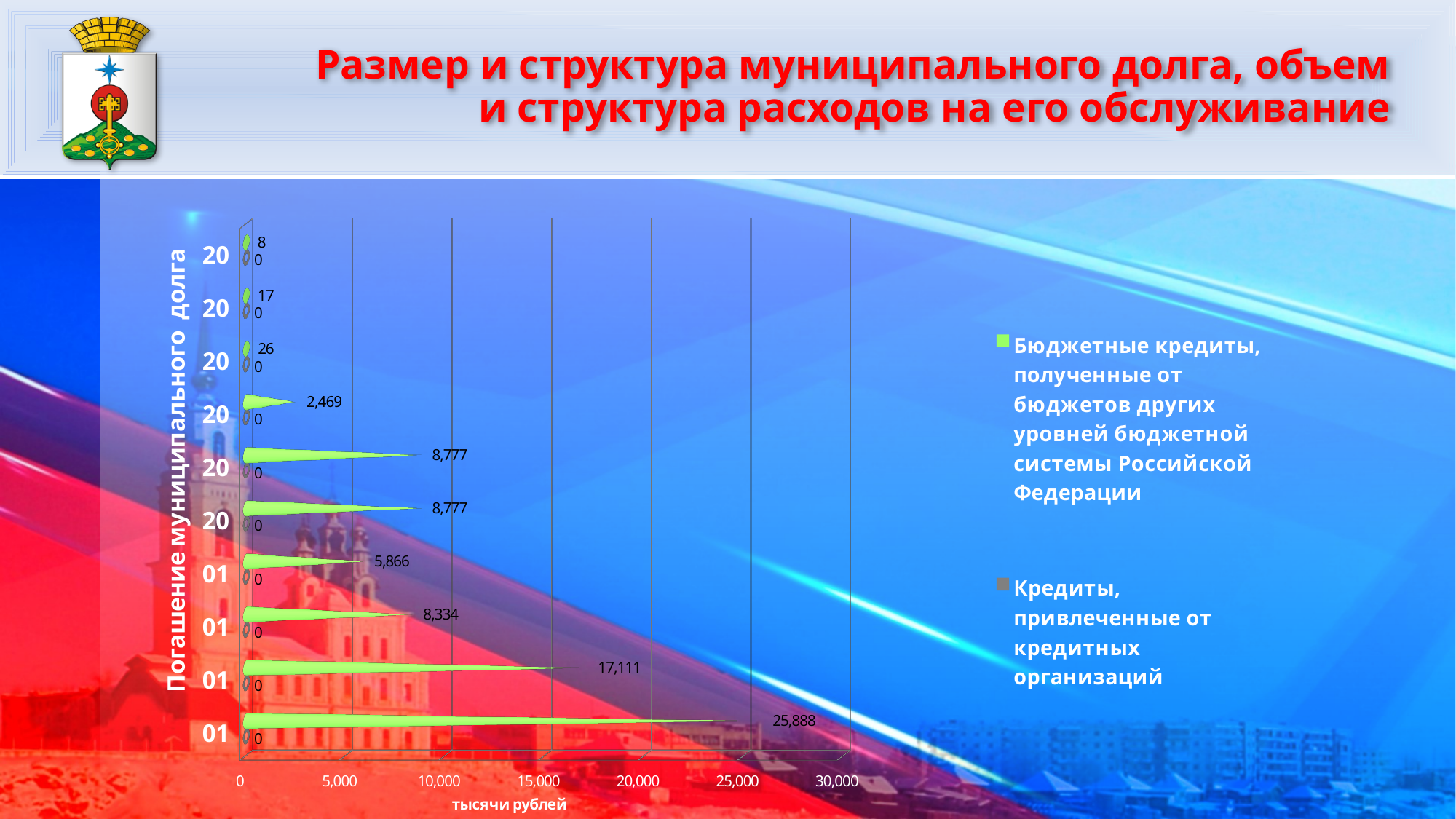
What kind of chart is shown on the slide? bar chart What is the title of the horizontal (value) axis of the chart? тысячи рублей Is the largest bar on the chart greater or less than 25,000? greater How many bars on the chart are labelled 8,777? 2 Reading the bars from top to bottom, do the green-series values generally rise or fall? rise What value is shown for the grey series (Кредиты, привлеченные от кредитных организаций) in every category? 0 What is the lowest value shown for the green series (Бюджетные кредиты)? 8 What is the difference between the highest green-series value (25,888) and the lowest (8)? 25,880 What is the highest value shown for the green series (Бюджетные кредиты)? 25,888 How many categories (bars) are plotted on the chart? 10 How many series does the chart legend list? 2 What is the difference between the two largest green-series values, 25,888 and 17,111? 8,777